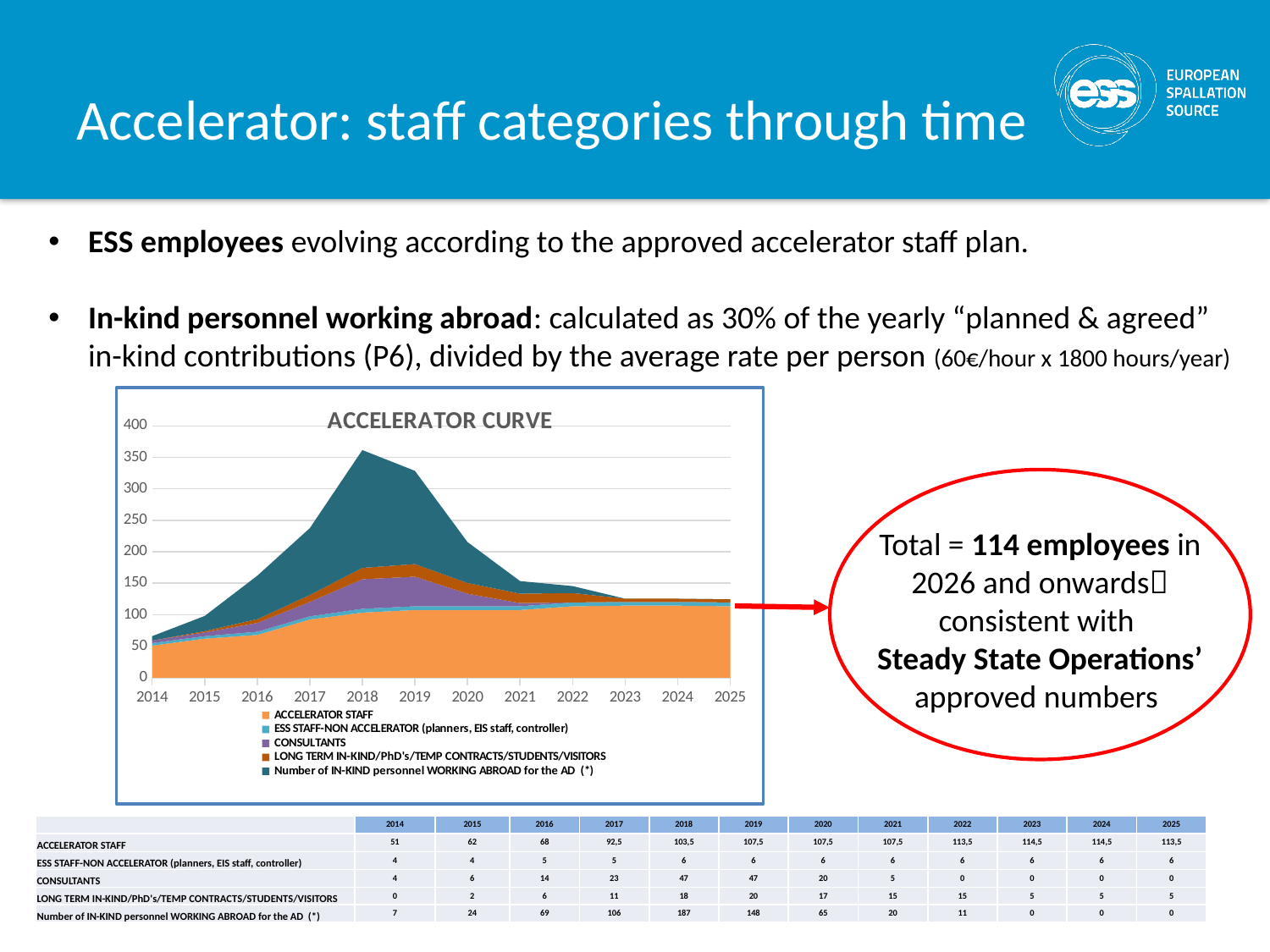
What is the Number of IN-KIND personnel WORKING ABROAD for the AD in 2018? 187 Does the Number of IN-KIND personnel WORKING ABROAD for the AD rise or fall from 2018 to 2025? fall What is the CONSULTANTS value for 2017? 23 How many years are shown along the x axis of the ACCELERATOR CURVE chart? 12 What is the LONG TERM IN-KIND/PhD's/TEMP CONTRACTS/STUDENTS/VISITORS value for 2019? 20 What is the total of all five stacked series in 2014? 66 Is the total stacked value for 2018 in the ACCELERATOR CURVE chart greater or less than 300? greater By how much does ACCELERATOR STAFF in 2025 exceed ACCELERATOR STAFF in 2014? 62,5 In which year is the Number of IN-KIND personnel WORKING ABROAD for the AD highest? 2018 How many series does the legend of the ACCELERATOR CURVE chart list? 5 Which year has the larger CONSULTANTS value, 2018 or 2020? 2018 What kind of chart is the ACCELERATOR CURVE chart? area chart